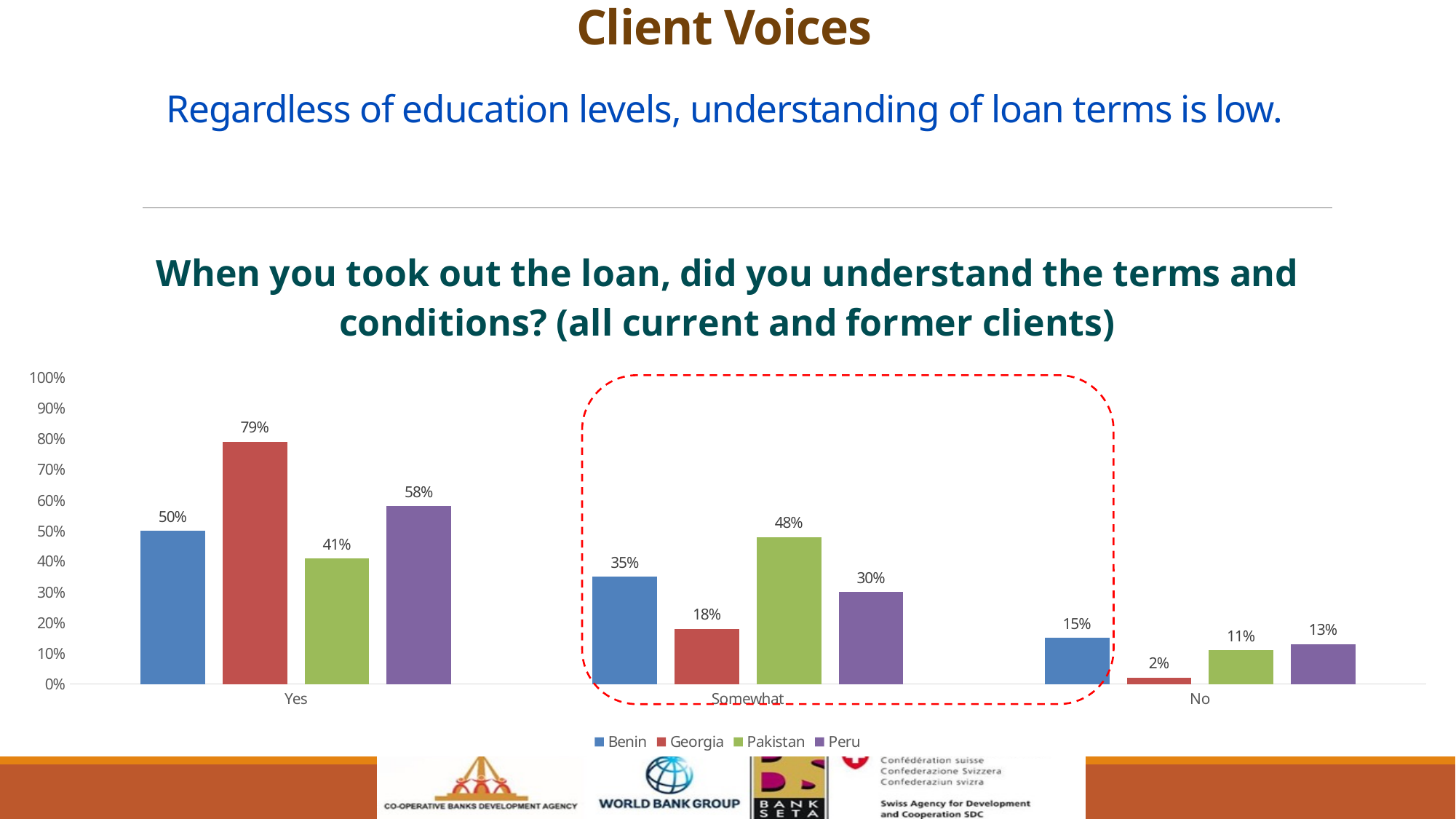
How many countries does the legend list? 4 Which is larger: Benin's "Somewhat" value or Peru's "Somewhat" value? Benin What percentage of Georgia clients answered "No"? 2% What percentage of Georgia clients answered "Yes" to understanding the loan terms and conditions? 79% Which country has the highest share of clients answering "Yes"? Georgia Which country has the lowest share of clients answering "Somewhat"? Georgia What type of chart is shown on the slide? bar chart Is the value for Pakistan in the "Yes" category greater or less than 50%? less Which response category is highlighted with a red dashed outline? Somewhat What is the difference between Peru's and Benin's "Yes" percentages? 8% What percentage of Pakistan clients answered "Somewhat"? 48% How many response categories are shown on the x axis? 3